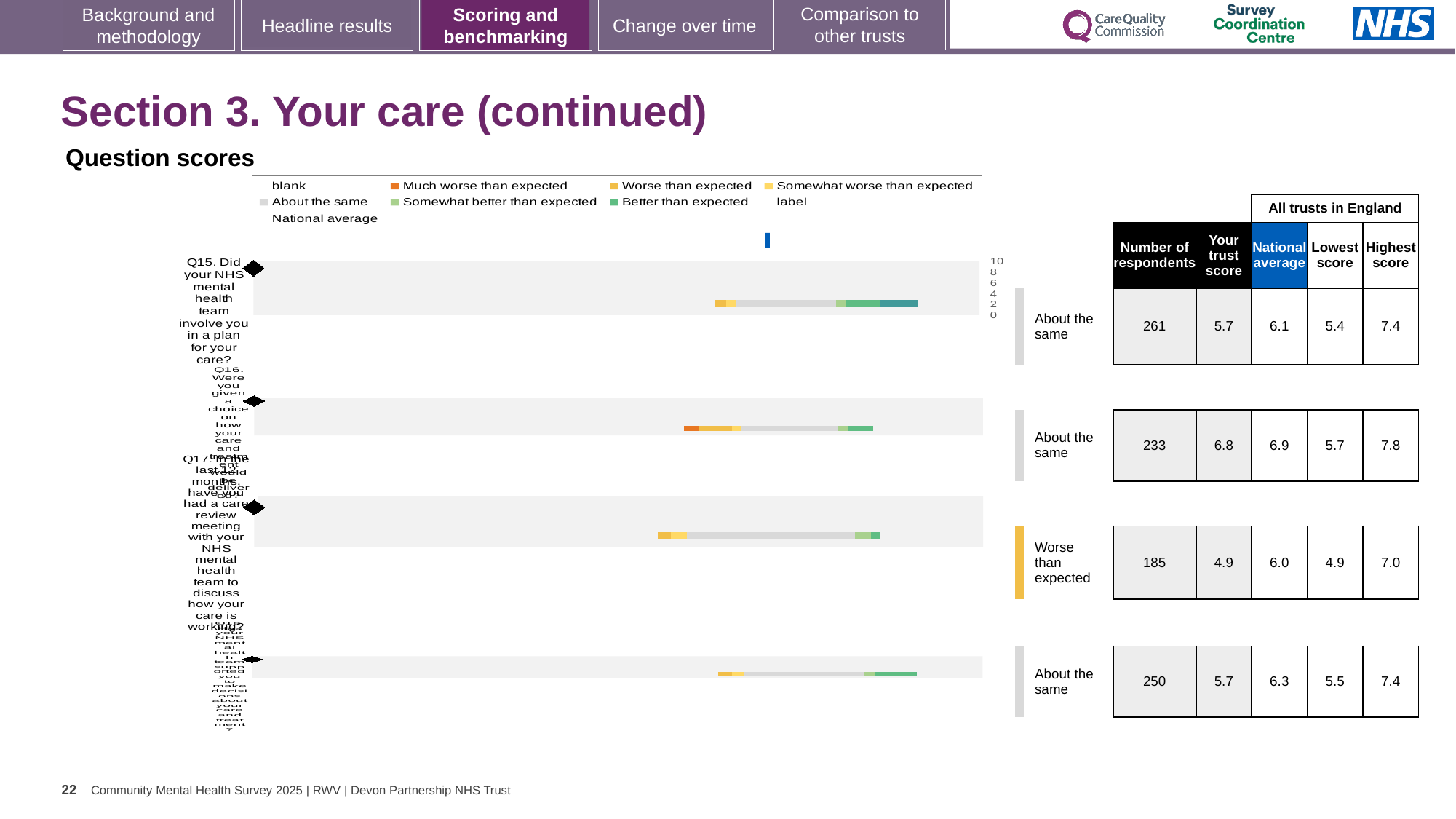
How many questions (bars) are plotted in the question scores chart? 4 Which has the higher trust score, Q15 or Q16? Q16 What is the trust score for Q15 (Did your NHS mental health team involve you in a plan for your care?)? 5.7 What benchmark category is shown for Q15? About the same Which question has the lowest number of respondents? Q17 How many respondents answered Q17 (In the last 12 months, have you had a care review meeting)? 185 By how much is the national average for Q17 higher than the trust score for Q17? 1.1 What is the national average for Q16 (Were you given a choice on how your care and treatment would be delivered)? 6.9 What benchmark category is shown for Q17? Worse than expected Which question has the highest trust score? Q16 What is the highest score across all trusts in England for Q16? 7.8 What kind of chart is used to show the question scores on this slide? bar chart